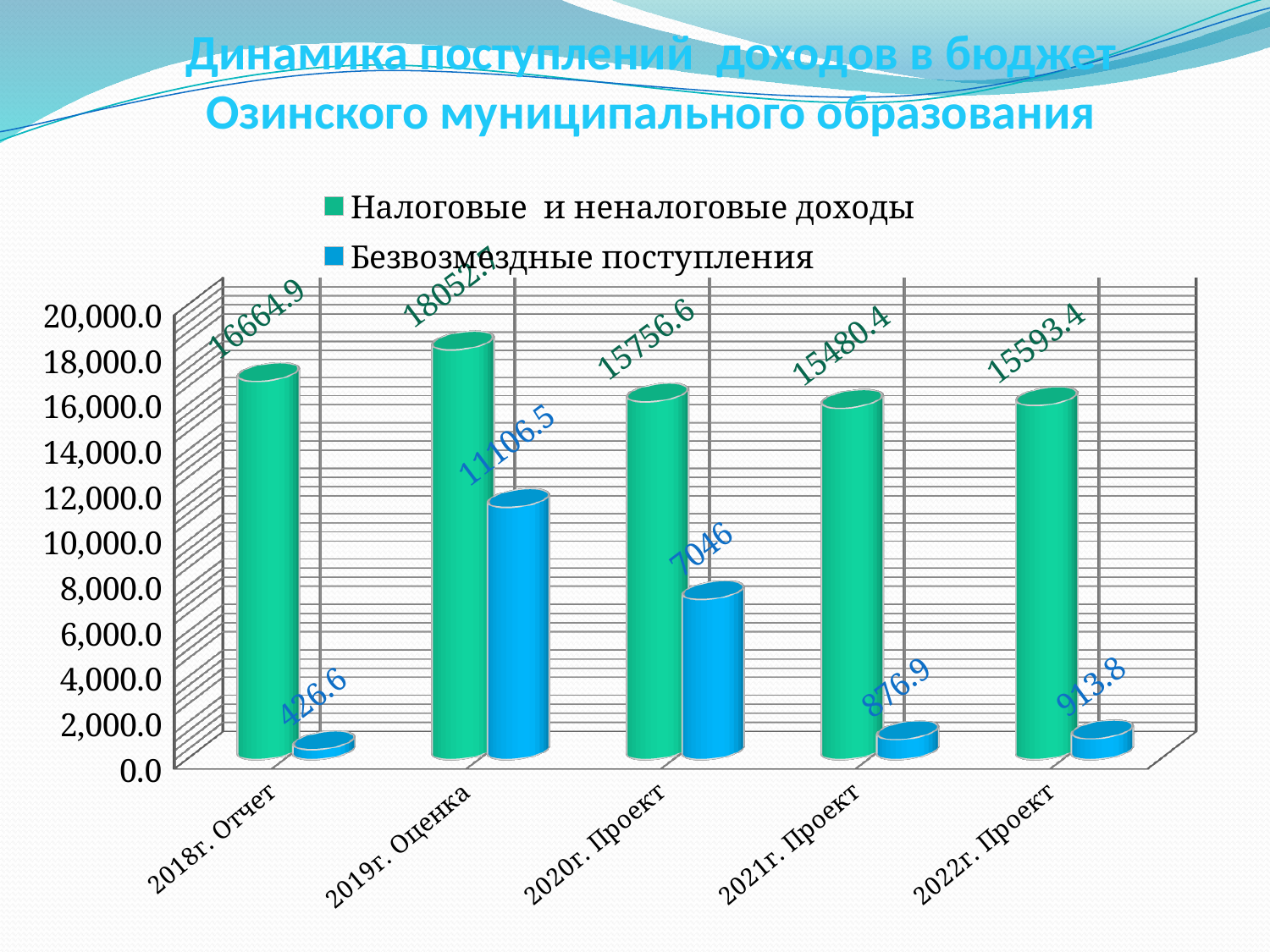
Is the value of Налоговые и неналоговые доходы for 2022г. Проект greater or less than 14,000.0? greater In which category is Налоговые и неналоговые доходы highest? 2019г. Оценка What type of chart is shown on the slide? bar chart What is the difference between Налоговые и неналоговые доходы and Безвозмездные поступления for 2021г. Проект? 14603.5 What is the value of Безвозмездные поступления for 2020г. Проект? 7046 Which is larger: Безвозмездные поступления for 2019г. Оценка or for 2020г. Проект? 2019г. Оценка In which category is Безвозмездные поступления lowest? 2018г. Отчет How many series does the legend list? 2 How many categories are shown on the x axis? 5 Which colour represents Безвозмездные поступления in the chart? blue What is the value of Налоговые и неналоговые доходы for 2019г. Оценка? 18052.7 What is the value of Безвозмездные поступления for 2018г. Отчет? 426.6